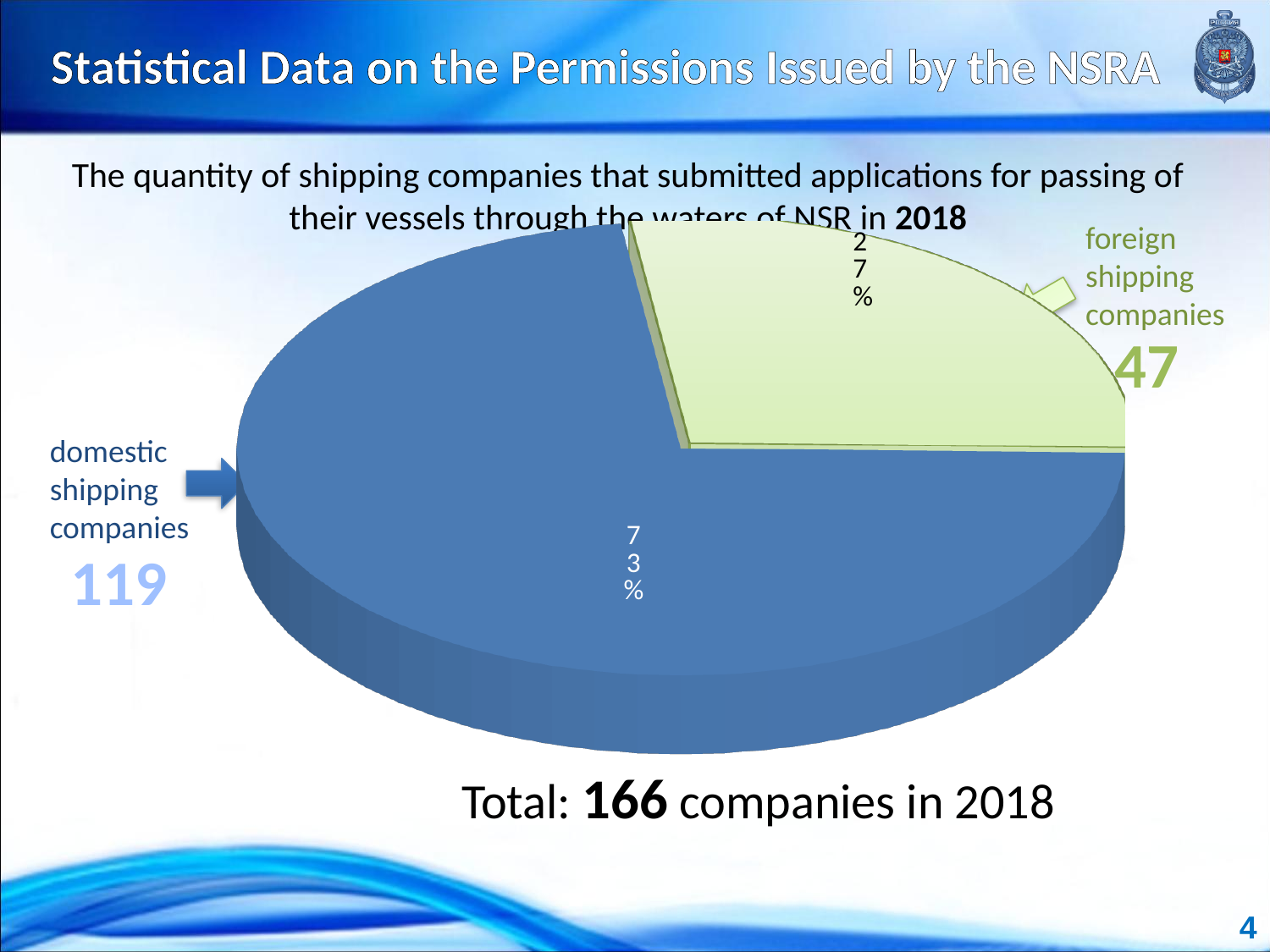
What is the total number of companies shown for 2018? 166 What percentage of the pie do domestic shipping companies represent? 73% How many domestic shipping companies submitted applications in 2018? 119 Which is larger: the number of foreign shipping companies or the number of domestic shipping companies? domestic shipping companies Which category has the larger slice of the pie? domestic shipping companies What percentage of the pie do foreign shipping companies represent? 27% How many slices does the pie chart have? 2 How many foreign shipping companies submitted applications in 2018? 47 What kind of chart is shown on the slide? pie chart What colour is the slice for foreign shipping companies? light green Which category has the smaller slice of the pie? foreign shipping companies What is the difference between the number of domestic and foreign shipping companies? 72